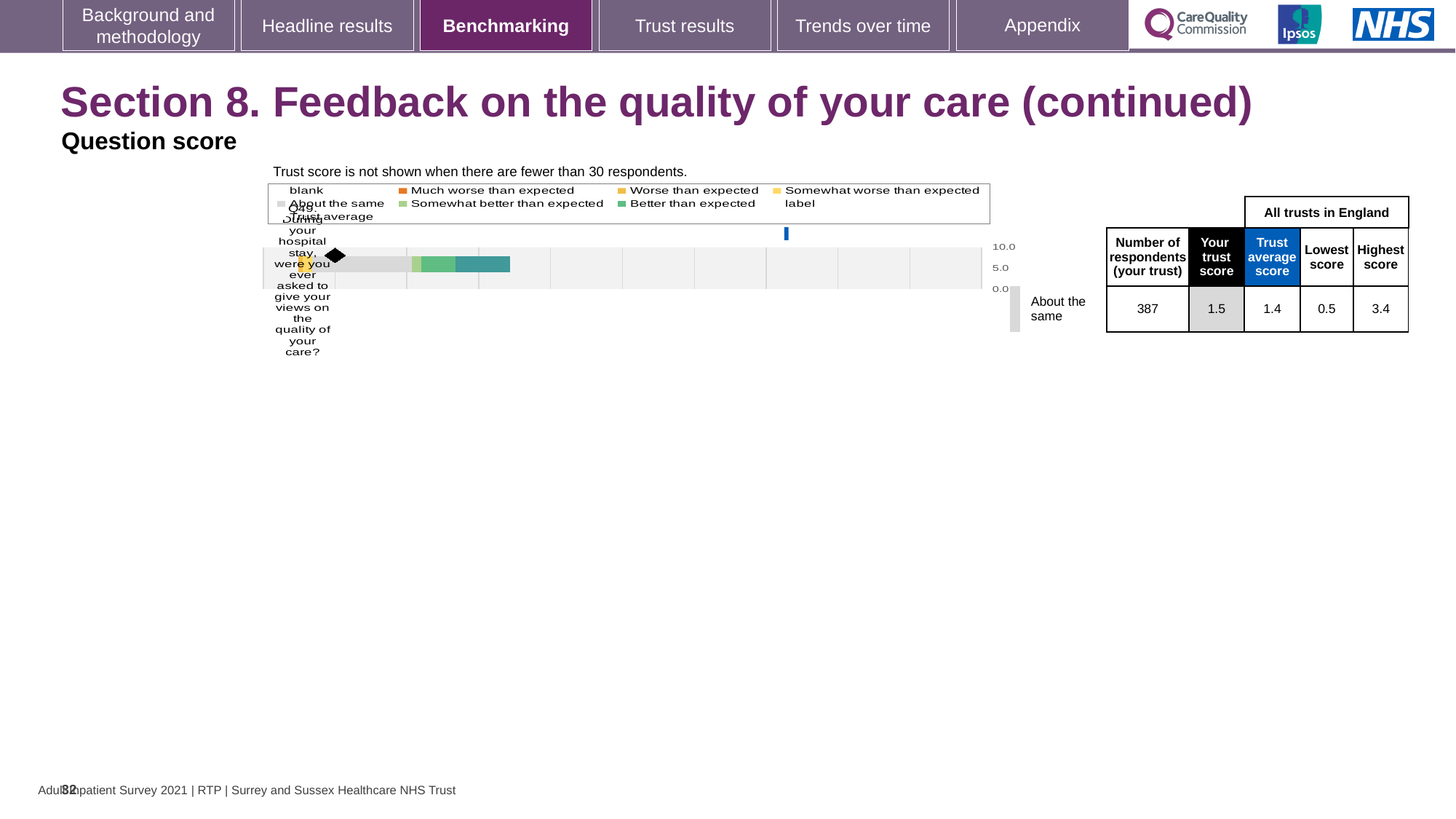
What is the lowest score across all trusts in England for Q49? 0.5 How many survey questions are plotted in the benchmarking chart? 1 What benchmark category is Q49 placed in, as labelled to the right of the chart? About the same What is the trust score for Q49 shown in the table beside the chart? 1.5 Which is larger for Q49, your trust score or the trust average score? Your trust score What is the difference between the highest score and the lowest score for Q49? 2.9 How many respondents from your trust answered Q49? 387 Which question number is plotted in the benchmarking chart? Q49 What kind of chart is used to show the Q49 benchmarking result? bar chart What is the trust average score for Q49 shown in the table beside the chart? 1.4 What is the highest score across all trusts in England for Q49? 3.4 According to the note above the chart, the trust score is not shown when there are fewer than how many respondents? 30